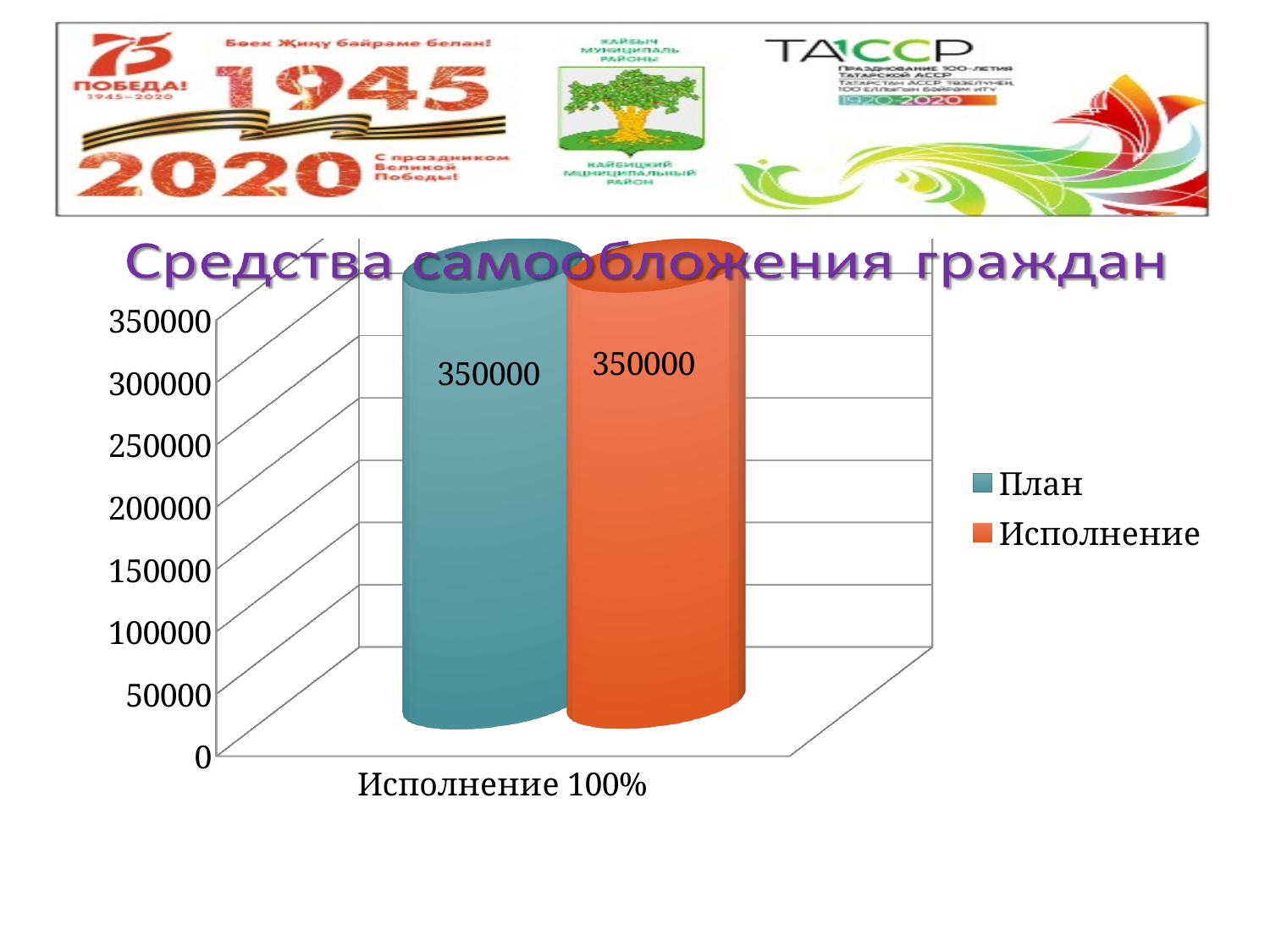
What is the title of the chart? Средства самообложения граждан Is the value for Исполнение greater or less than 300000? greater What kind of chart is shown on the slide? bar chart How many series does the chart legend list? 2 What is the value of the Исполнение series on the chart? 350000 What is the value of the План series on the chart? 350000 What is the highest value shown on the vertical axis of the chart? 350000 Is the value for План greater or less than 200000? greater What is the category label shown on the x axis of the chart? Исполнение 100% What is the difference between the План and Исполнение values? 0 How many categories are shown on the x axis of the chart? 1